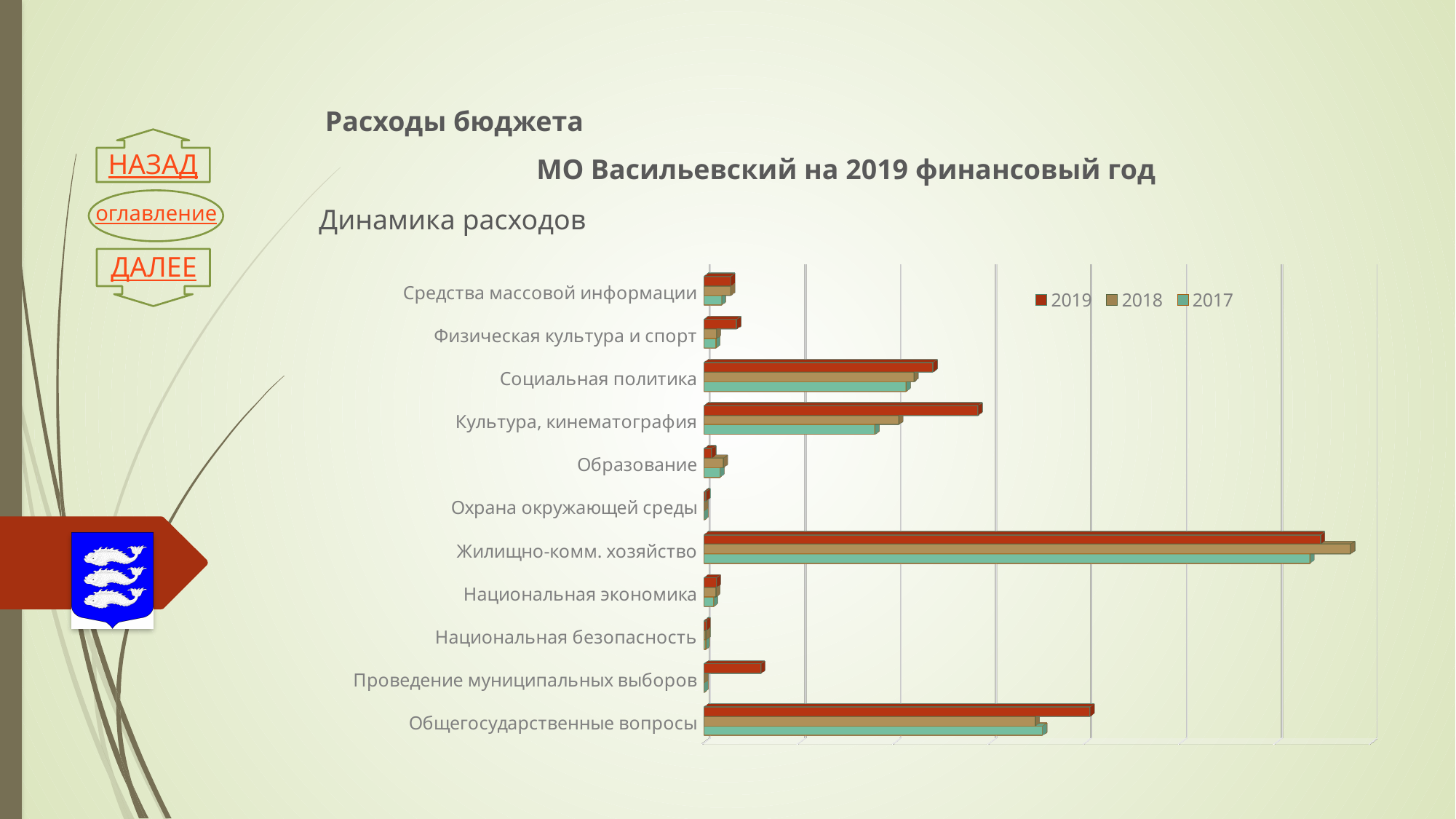
How many series does the legend list? 3 Which category has the highest value for 2017? Жилищно-комм. хозяйство For Жилищно-комм. хозяйство, which is larger: the 2018 value or the 2019 value? 2018 For Общегосударственные вопросы, which is larger: the 2019 value or the 2017 value? 2019 Which category has the highest value for 2018? Жилищно-комм. хозяйство Which years are listed in the chart legend? 2019, 2018, 2017 For Культура, кинематография, which is larger: the 2019 value or the 2017 value? 2019 How many expenditure categories are shown on the chart? 11 What kind of chart is shown on the slide? Bar chart Which category has the second highest value for 2019, after Жилищно-комм. хозяйство? Общегосударственные вопросы